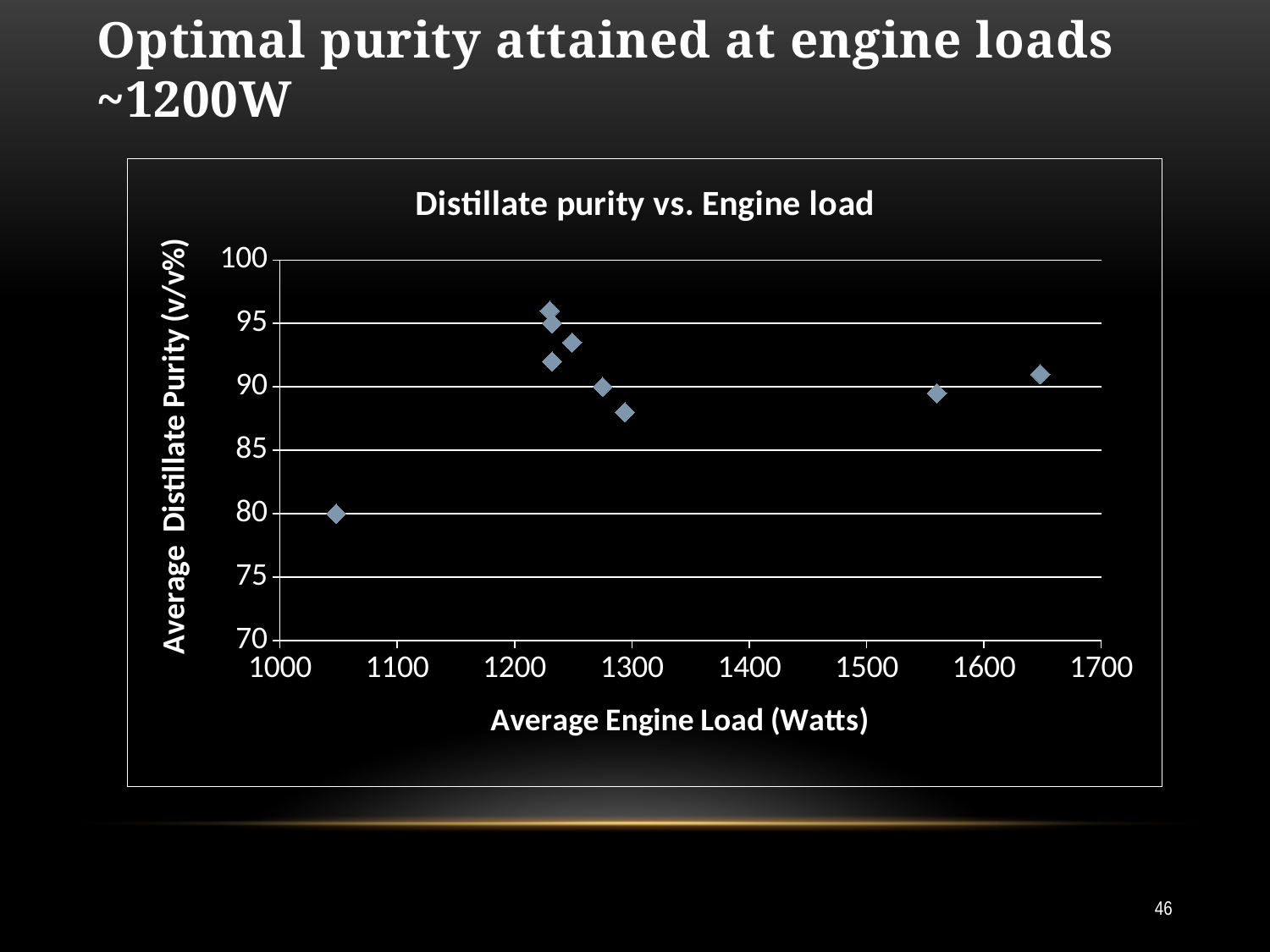
Is the purity value for the highest point near 1230 W greater or less than 95? greater Which point has the higher purity: the one at about 1295 W or the highest point near 1230 W? the one near 1230 W Is the purity value for the point at about 1560 W greater or less than 85? greater What is the title of the chart? Distillate purity vs. Engine load Is the purity value for the point at about 1650 W greater or less than 85? greater What kind of chart is shown on the slide? scatter chart Which point has the higher purity: the one at about 1050 W or the one at about 1650 W? the one at about 1650 W How many data points are plotted in the 'Distillate purity vs. Engine load' chart? 9 What is the label of the x axis of the chart? Average Engine Load (Watts)